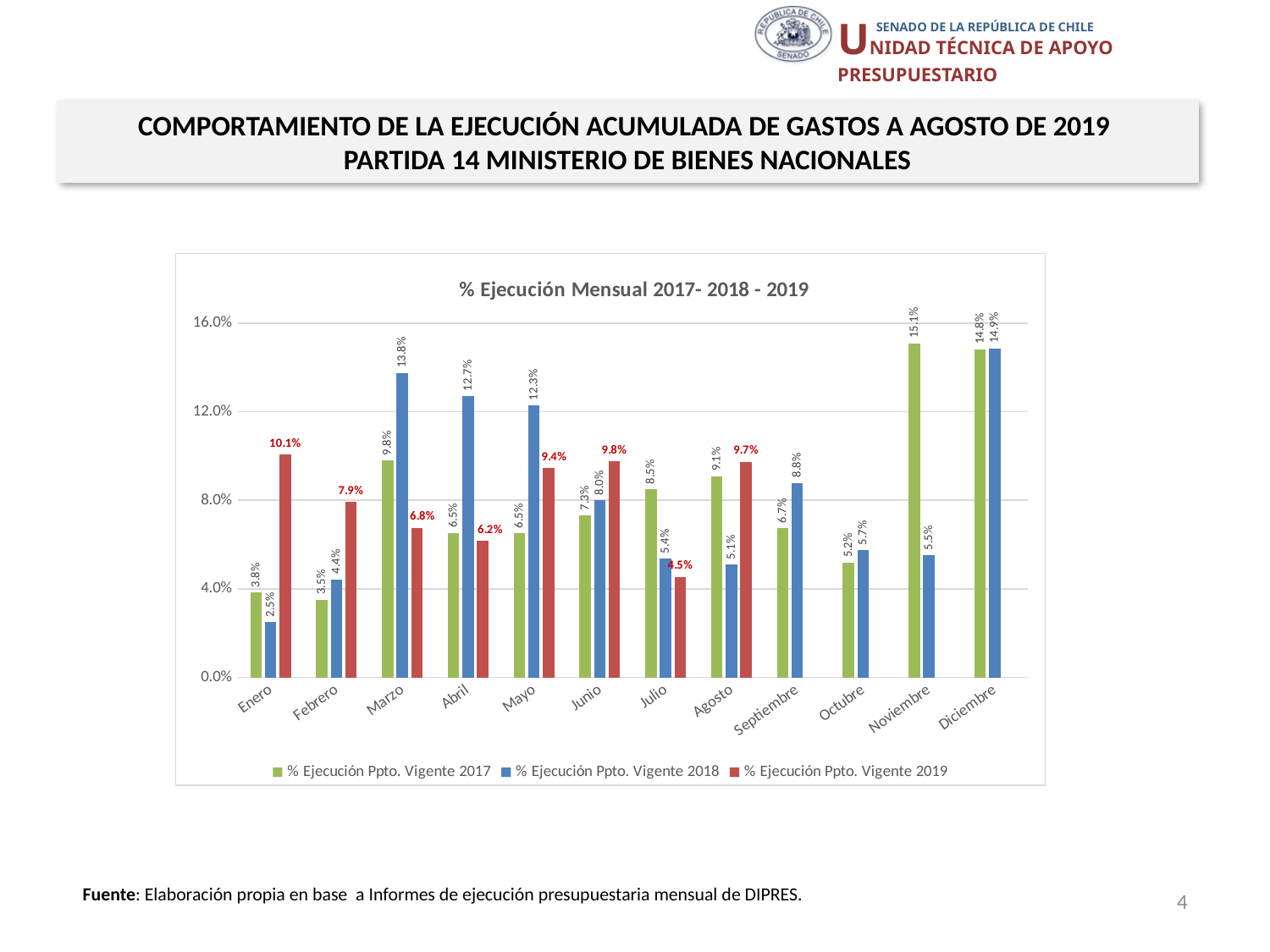
What is the value for Marzo in the % Ejecución Ppto. Vigente 2018 series? 13.8% What is the difference between the 2018 and 2017 values for Marzo? 4.0 percentage points What is the value for Noviembre in the % Ejecución Ppto. Vigente 2017 series? 15.1% Is the value for Abril in the % Ejecución Ppto. Vigente 2018 series greater or less than 12.0%? greater How many series does the legend list? 3 What is the value for Enero in the % Ejecución Ppto. Vigente 2019 series? 10.1% How many months are shown on the x axis of the chart? 12 Which month has the highest value in the % Ejecución Ppto. Vigente 2019 series? Enero Which month has the lowest value in the % Ejecución Ppto. Vigente 2019 series? Julio For Agosto, which series has the larger value: % Ejecución Ppto. Vigente 2017 or % Ejecución Ppto. Vigente 2019? % Ejecución Ppto. Vigente 2019 Which month has the lowest value in the % Ejecución Ppto. Vigente 2018 series? Enero What kind of chart is shown on the slide? Bar chart